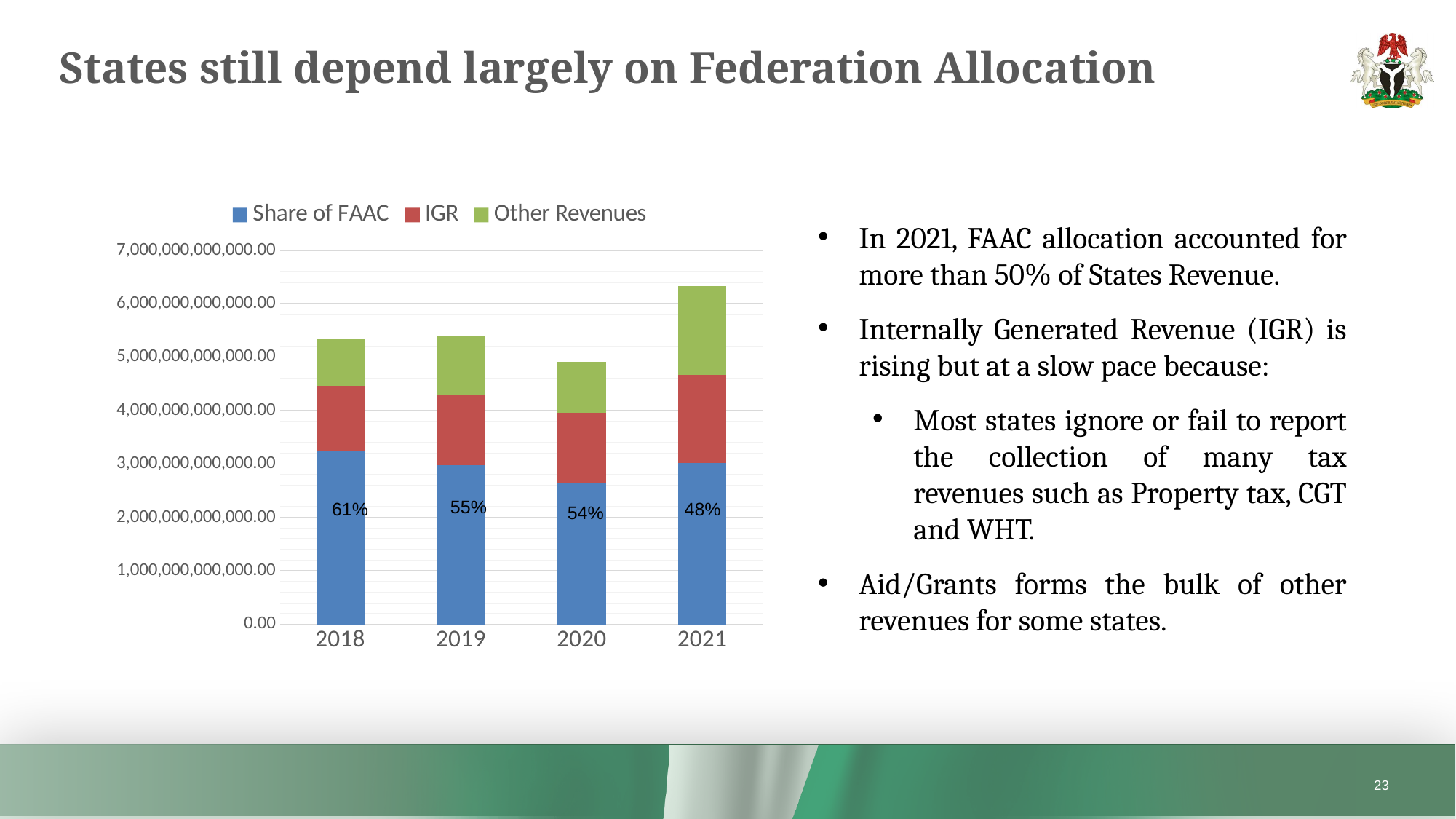
What kind of chart is shown on the slide? Stacked bar chart What percentage label is shown on the Share of FAAC bar for 2021? 48% Which year has the tallest stacked bar (highest total revenue)? 2021 How many series does the chart legend list? 3 By how many percentage points does the Share of FAAC label for 2018 exceed the label for 2021? 13 percentage points Which year has the shortest stacked bar (lowest total revenue)? 2020 Is the Share of FAAC segment for 2020 greater or less than 3,000,000,000,000.00? less Do the Share of FAAC percentage labels rise or fall from 2018 to 2021? Fall What percentage label is shown on the Share of FAAC bar for 2018? 61% What percentage label is shown on the Share of FAAC bar for 2020? 54% Is the total stacked bar for 2021 greater or less than 6,000,000,000,000.00? greater How many years are shown on the x axis of the chart? 4